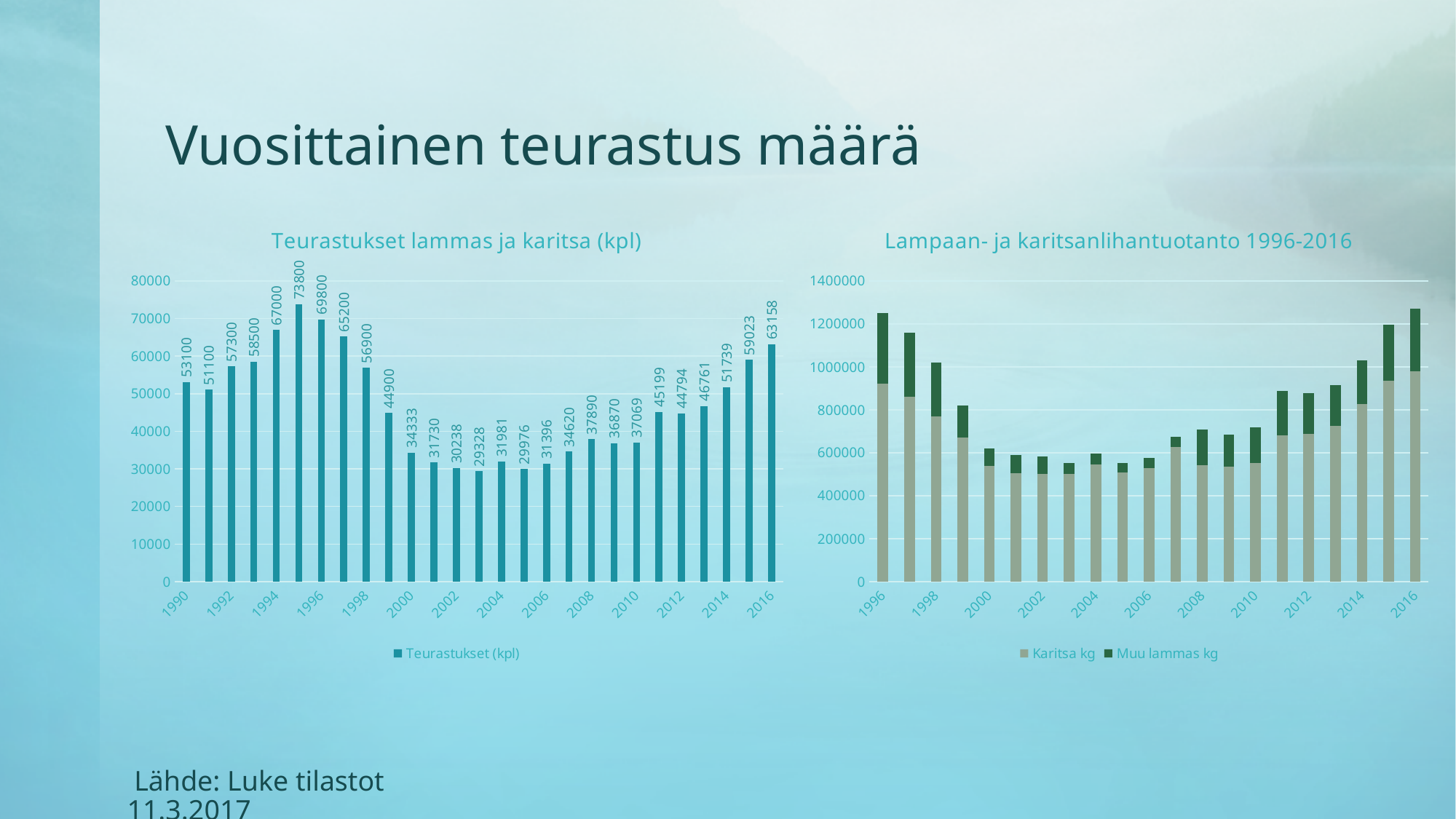
In the chart 'Teurastukset lammas ja karitsa (kpl)', which is larger, the value for 1990 or the value for 2016? 2016 In the chart 'Lampaan- ja karitsanlihantuotanto 1996-2016', how many series does the legend list? 2 In the chart 'Teurastukset lammas ja karitsa (kpl)', what is the value for 1995? 73800 In the chart 'Lampaan- ja karitsanlihantuotanto 1996-2016', is the total for 2003 greater or less than 600000? less In the chart 'Teurastukset lammas ja karitsa (kpl)', what is the difference between the values for 1995 and 2003? 44472 In the chart 'Lampaan- ja karitsanlihantuotanto 1996-2016', is the total for 2016 greater or less than 1200000? greater What kind of chart is 'Teurastukset lammas ja karitsa (kpl)'? Bar chart In the chart 'Teurastukset lammas ja karitsa (kpl)', how many years are plotted? 27 In the chart 'Teurastukset lammas ja karitsa (kpl)', which year has the lowest value? 2003 In the chart 'Teurastukset lammas ja karitsa (kpl)', what is the value for 2016? 63158 In the chart 'Teurastukset lammas ja karitsa (kpl)', which year has the highest value? 1995 In the chart 'Lampaan- ja karitsanlihantuotanto 1996-2016', what are the two legend entries? Karitsa kg and Muu lammas kg